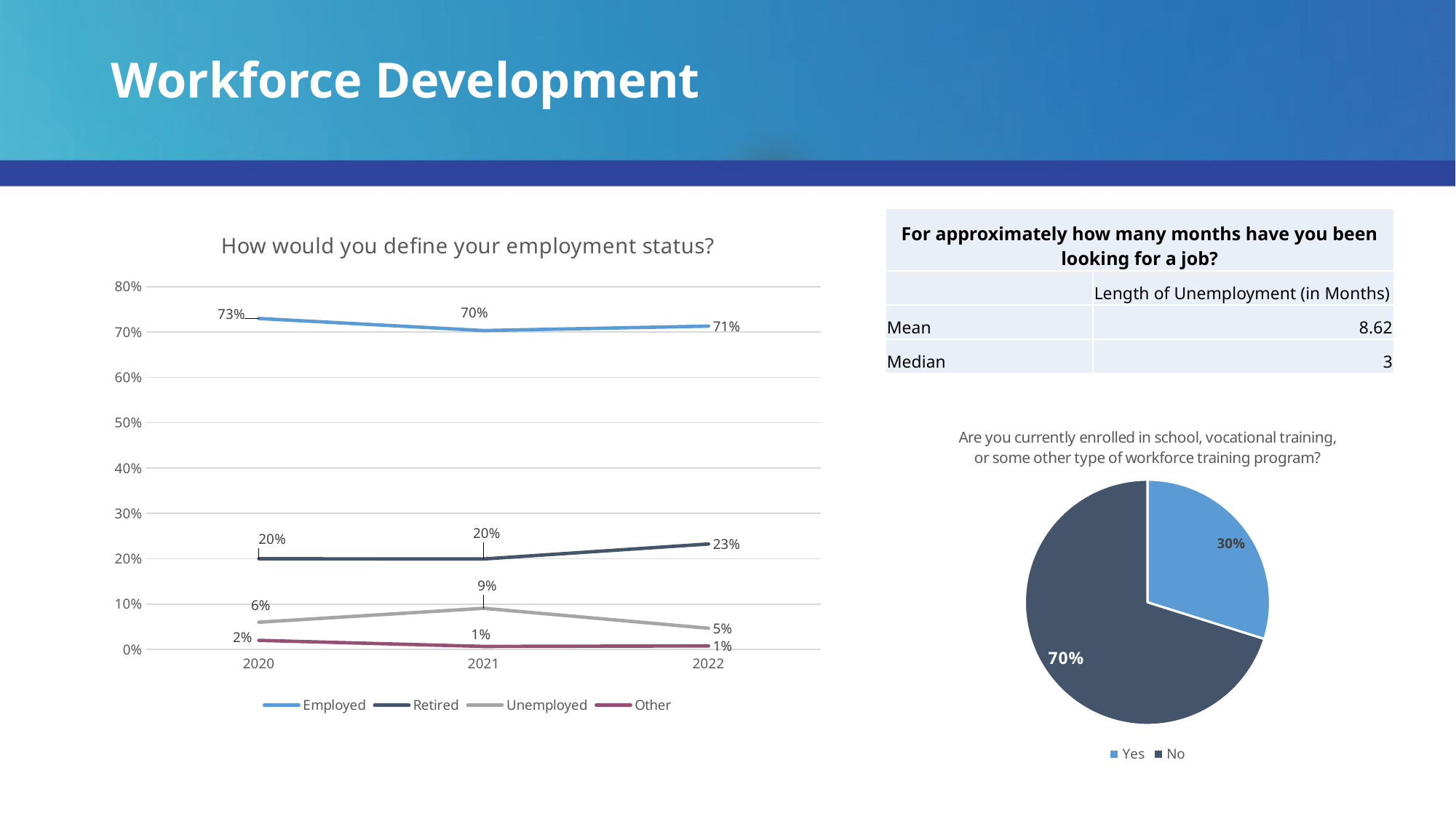
In the 'How would you define your employment status?' chart, what is the difference between the Employed percentage in 2020 and in 2021? 3% In the 'How would you define your employment status?' chart, does the Retired percentage rise or fall from 2021 to 2022? Rise What kind of chart is used for the question 'Are you currently enrolled in school, vocational training, or some other type of workforce training program?' Pie chart In the pie chart about enrollment in school, vocational training, or a workforce training program, what share of respondents answered No? 70% In the 'How would you define your employment status?' chart, what percentage of respondents were Retired in 2022? 23% What kind of chart is 'How would you define your employment status?' Line chart In the 'How would you define your employment status?' chart, which year had the highest Employed percentage? 2020 In the 'How would you define your employment status?' chart, which year had the lowest Unemployed percentage? 2022 In the 'How would you define your employment status?' chart, what percentage of respondents were Unemployed in 2021? 9% In the 'How would you define your employment status?' chart, which is larger: the Retired percentage in 2022 or the Unemployed percentage in 2022? Retired In the 'How would you define your employment status?' chart, how many series does the legend list? 4 In the 'How would you define your employment status?' chart, what percentage of respondents were Employed in 2020? 73%